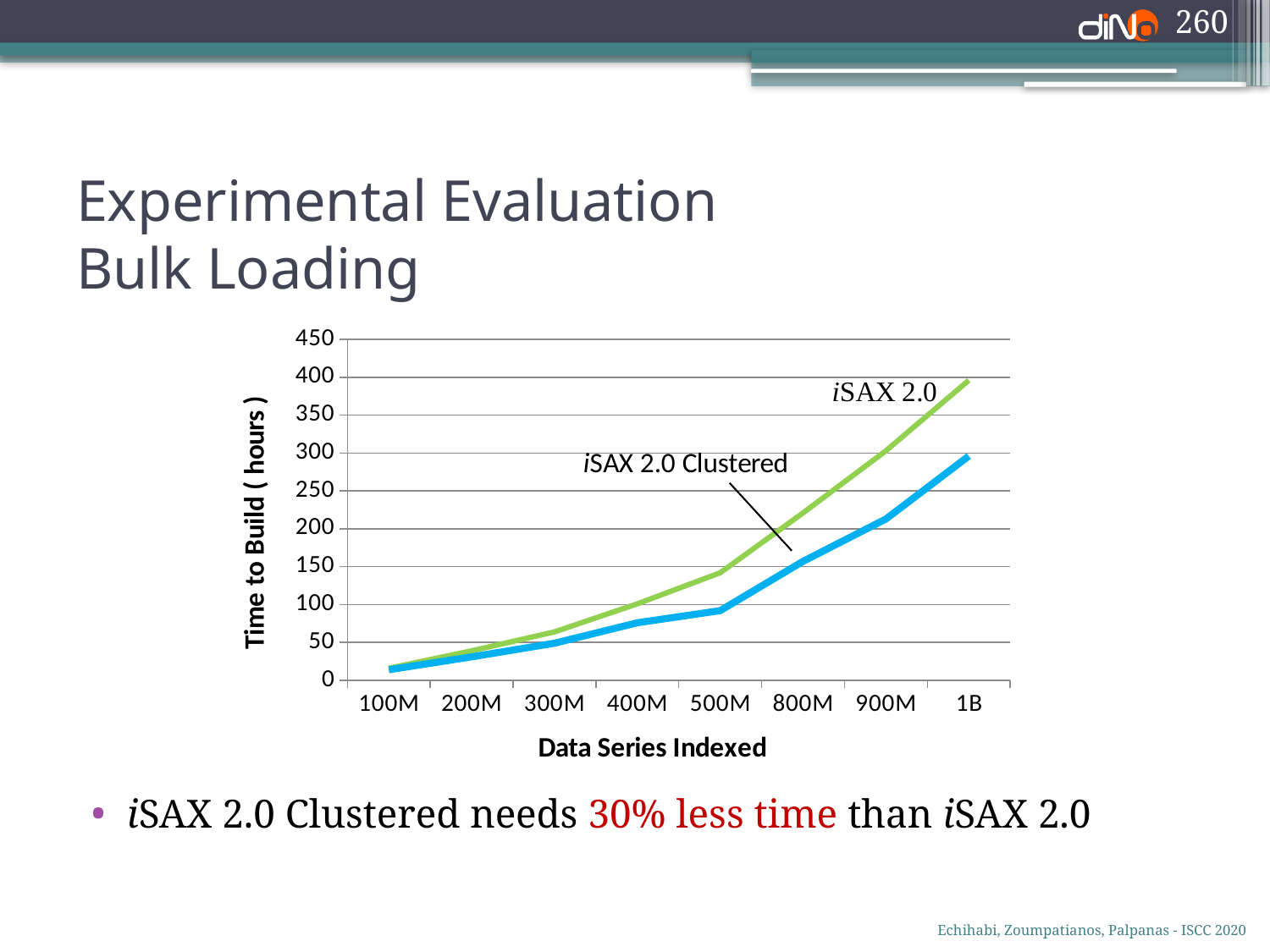
Is the time to build for iSAX 2.0 Clustered at 1B data series greater or less than 250 hours? greater Do the build times rise or fall as the number of data series indexed increases? rise How many data series are plotted on the chart? 2 What kind of chart is shown on the slide? line chart How many points are shown along the x axis (Data Series Indexed)? 8 Is the time to build for iSAX 2.0 at 1B data series greater or less than 350 hours? greater At 1B data series indexed, which series has the higher time to build, iSAX 2.0 or iSAX 2.0 Clustered? iSAX 2.0 What is the label of the y axis? Time to Build ( hours ) Is the time to build for iSAX 2.0 at 500M data series greater or less than 100 hours? greater What is the label of the x axis? Data Series Indexed